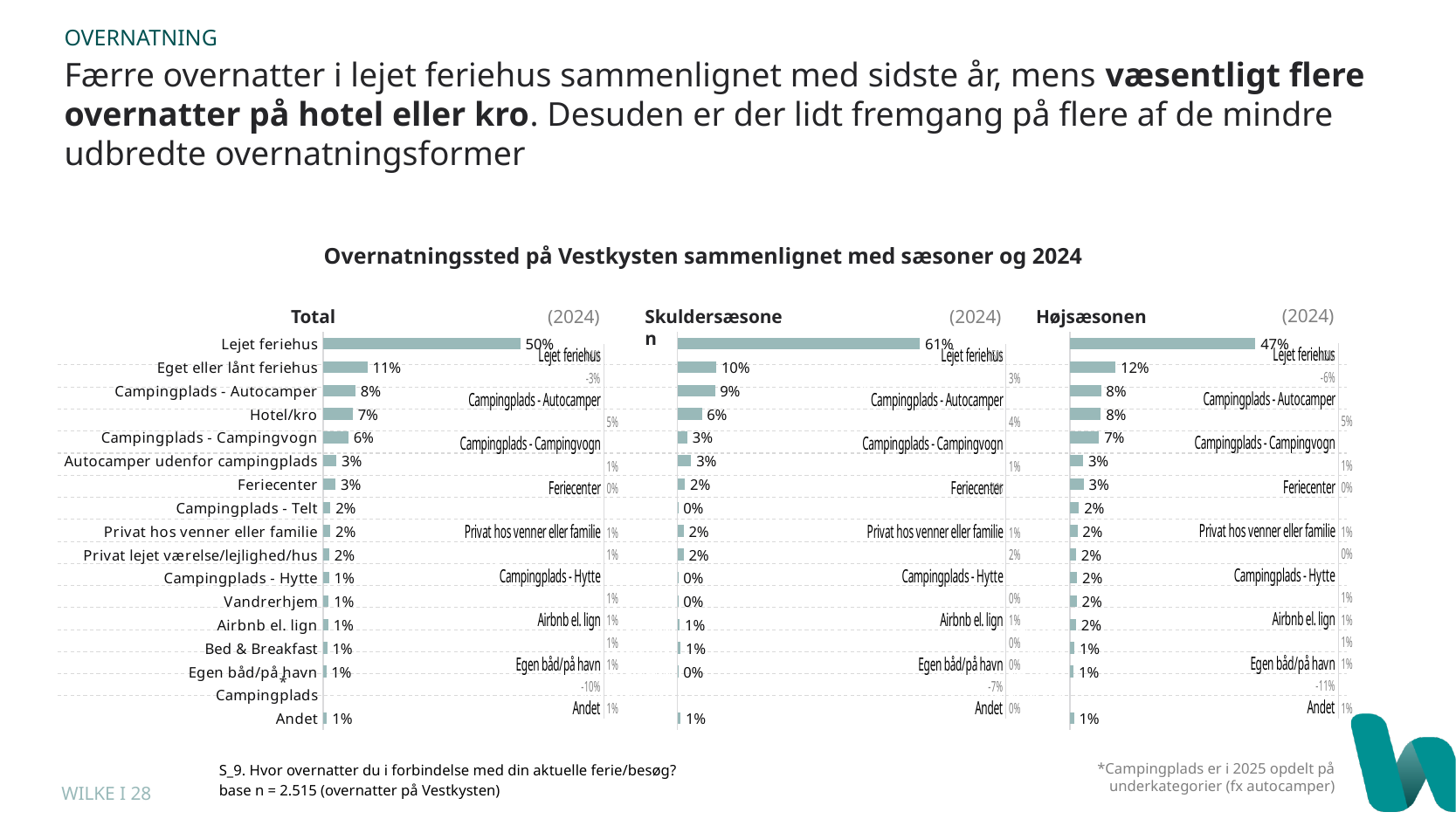
In the Total chart, which category has the highest value? Lejet feriehus In the Total chart, what is the difference between Lejet feriehus and Eget eller lånt feriehus? 39 percentage points What type of chart is used for the Total, Skuldersæsonen and Højsæsonen panels? Bar chart In the Skuldersæsonen chart, what is the value for Lejet feriehus? 61% In the Total chart, what is the value for Hotel/kro? 7% What is the difference between the Lejet feriehus value in the Skuldersæsonen chart and in the Højsæsonen chart? 14 percentage points In the Højsæsonen chart, what is the value for Eget eller lånt feriehus? 12% What is the title of the chart group on the slide? Overnatningssted på Vestkysten sammenlignet med sæsoner og 2024 In the Total chart, what is the value for Lejet feriehus? 50% In the Højsæsonen chart, what is the value for Campingplads - Campingvogn? 7% In the Skuldersæsonen chart, which is larger: Eget eller lånt feriehus or Hotel/kro? Eget eller lånt feriehus In the Skuldersæsonen chart, what is the value for Campingplads - Autocamper? 9%